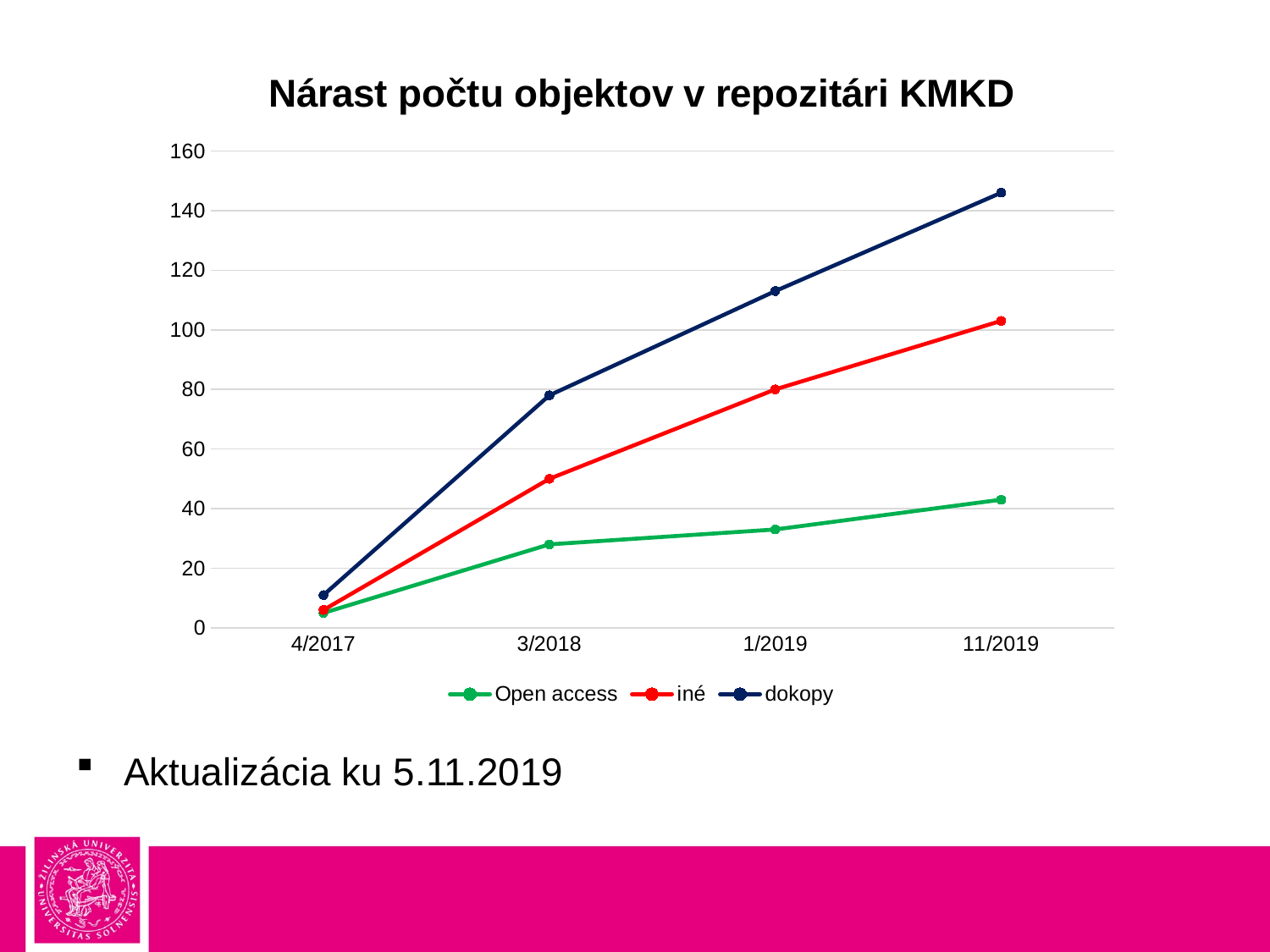
Is the value for dokopy at 1/2019 greater or less than 100? greater Do the values for dokopy rise or fall from 4/2017 to 11/2019? rise What is the title of the chart? Nárast počtu objektov v repozitári KMKD At 1/2019, which is larger: the value for iné or the value for Open access? iné How many time points are plotted along the x axis? 4 What kind of chart is shown on the slide? line chart Is the value for iné at 3/2018 greater or less than 40? greater Which series has the highest value at 11/2019? dokopy Which series has the lowest value at 11/2019? Open access Is the value for Open access at 11/2019 greater or less than 60? less How many series does the legend list? 3